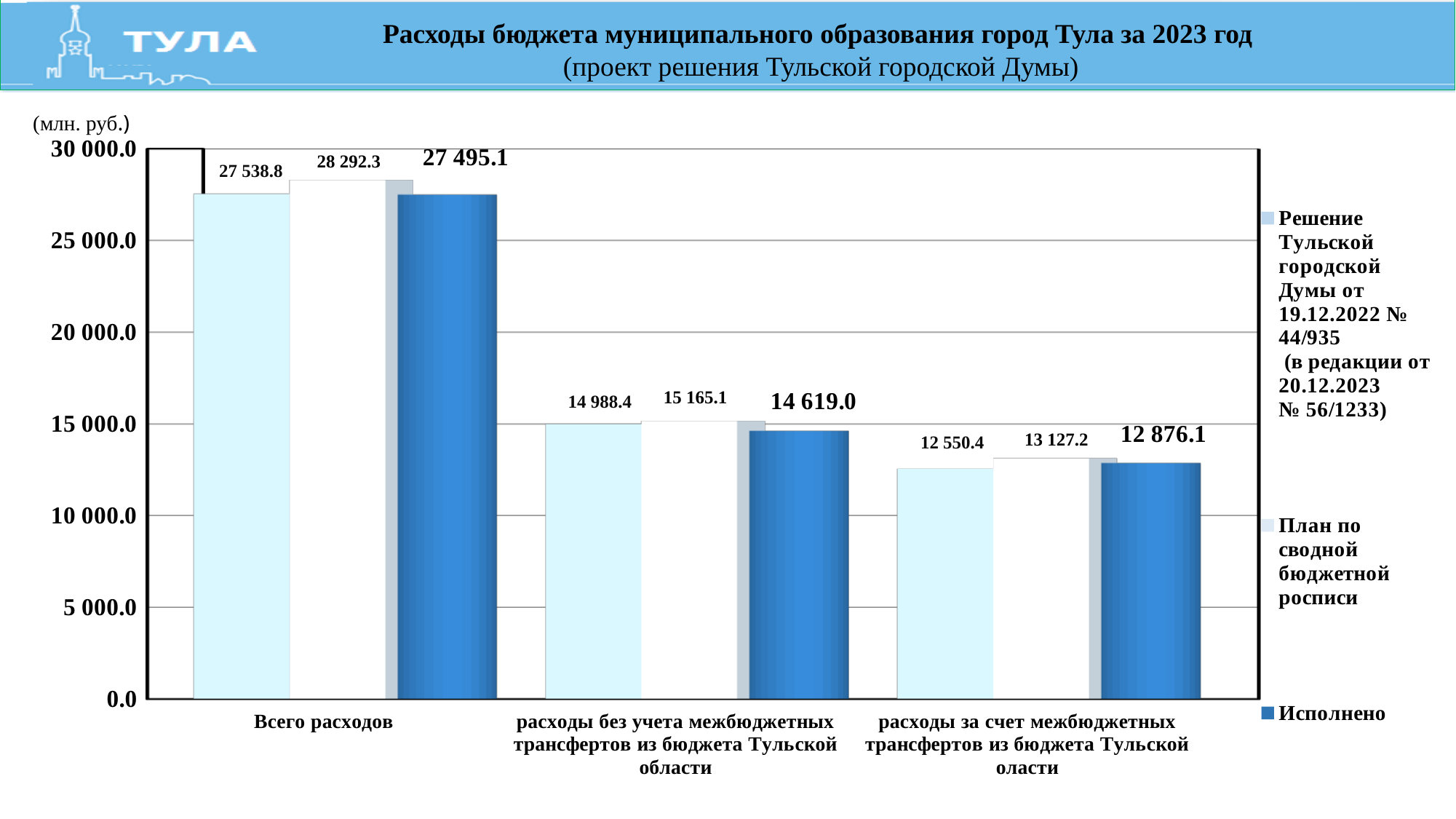
For "расходы за счет межбюджетных трансфертов из бюджета Тульской оласти", which is larger: "Исполнено" or "Решение Тульской городской Думы"? Исполнено How many categories are shown on the x axis? 3 Which category has the lowest "План по сводной бюджетной росписи" value? расходы за счет межбюджетных трансфертов из бюджета Тульской оласти What unit is stated above the y axis? млн. руб. How many series does the legend list? 3 What is the value of "Исполнено" for "Всего расходов"? 27 495.1 What type of chart is shown on the slide? bar chart What is the value of "Решение Тульской городской Думы" for "расходы за счет межбюджетных трансфертов из бюджета Тульской оласти"? 12 550.4 What is the value of "Исполнено" for "расходы без учета межбюджетных трансфертов из бюджета Тульской области"? 14 619.0 What is the value of "План по сводной бюджетной росписи" for "Всего расходов"? 28 292.3 Which category has the highest "Исполнено" value? Всего расходов What is the difference between "План по сводной бюджетной росписи" and "Исполнено" for "Всего расходов"? 797.2